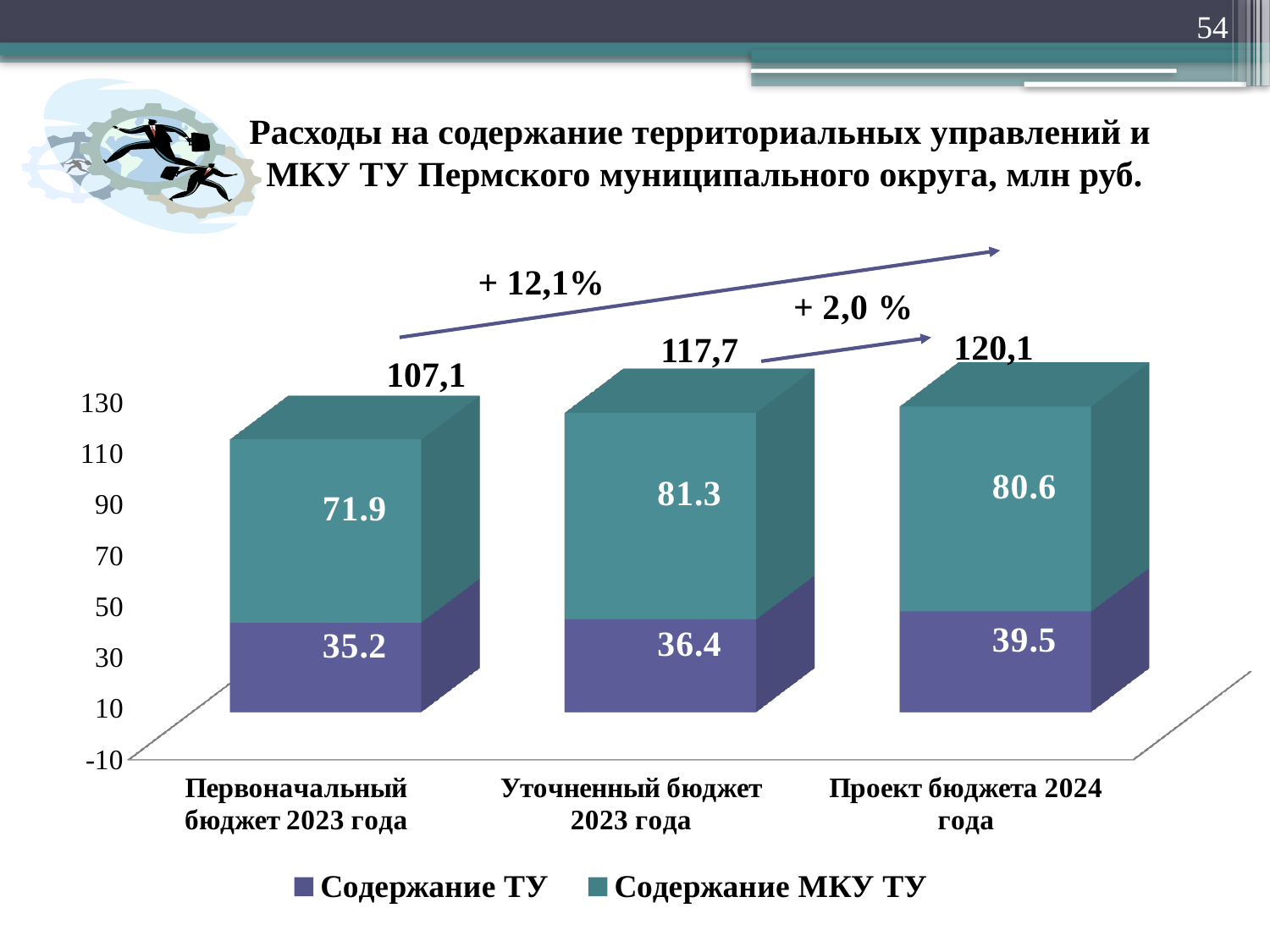
Which is larger: Содержание МКУ ТУ for Первоначальный бюджет 2023 года or for Проект бюджета 2024 года? Проект бюджета 2024 года What is the difference between Содержание ТУ for Проект бюджета 2024 года and for Уточненный бюджет 2023 года? 3.1 What is the value of Содержание МКУ ТУ for Проект бюджета 2024 года? 80.6 Which category has the lowest value for Содержание ТУ? Первоначальный бюджет 2023 года What kind of chart is shown on the slide? Stacked bar chart How many series does the legend list? 2 What is the value of Содержание ТУ for Первоначальный бюджет 2023 года? 35.2 What is the total of the stacked bar for Первоначальный бюджет 2023 года? 107,1 What is the value of Содержание МКУ ТУ for Уточненный бюджет 2023 года? 81.3 Which category has the highest value for Содержание МКУ ТУ? Уточненный бюджет 2023 года How many categories are shown on the x axis? 3 What is the total of the stacked bar for Проект бюджета 2024 года? 120,1